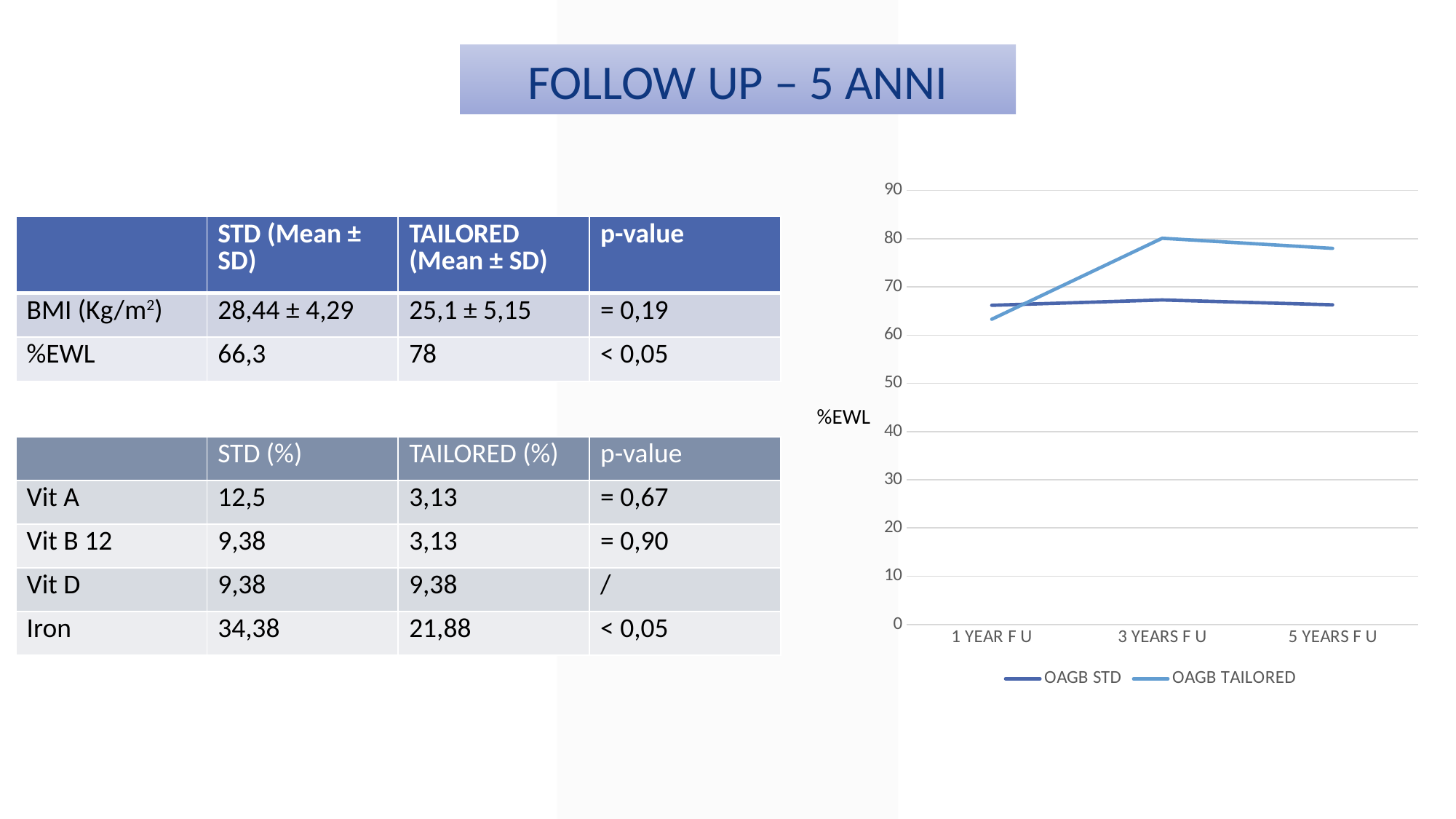
Is the value for OAGB TAILORED at 3 YEARS F U greater or less than 70? greater Is the value for OAGB STD at 1 YEAR F U greater or less than 60? greater At which follow-up time point does the OAGB TAILORED series reach its highest value? 3 YEARS F U Does the OAGB TAILORED series rise or fall from 1 YEAR F U to 3 YEARS F U? rise At 3 YEARS F U, which series has the higher value, OAGB STD or OAGB TAILORED? OAGB TAILORED What kind of chart is shown on the right of the slide? line chart How many series does the chart legend list? 2 Is the value for OAGB STD at 5 YEARS F U greater or less than 70? less What are the two series named in the chart legend? OAGB STD and OAGB TAILORED How many follow-up time points are plotted along the x axis of the chart? 3 What label is shown on the vertical axis of the chart? %EWL